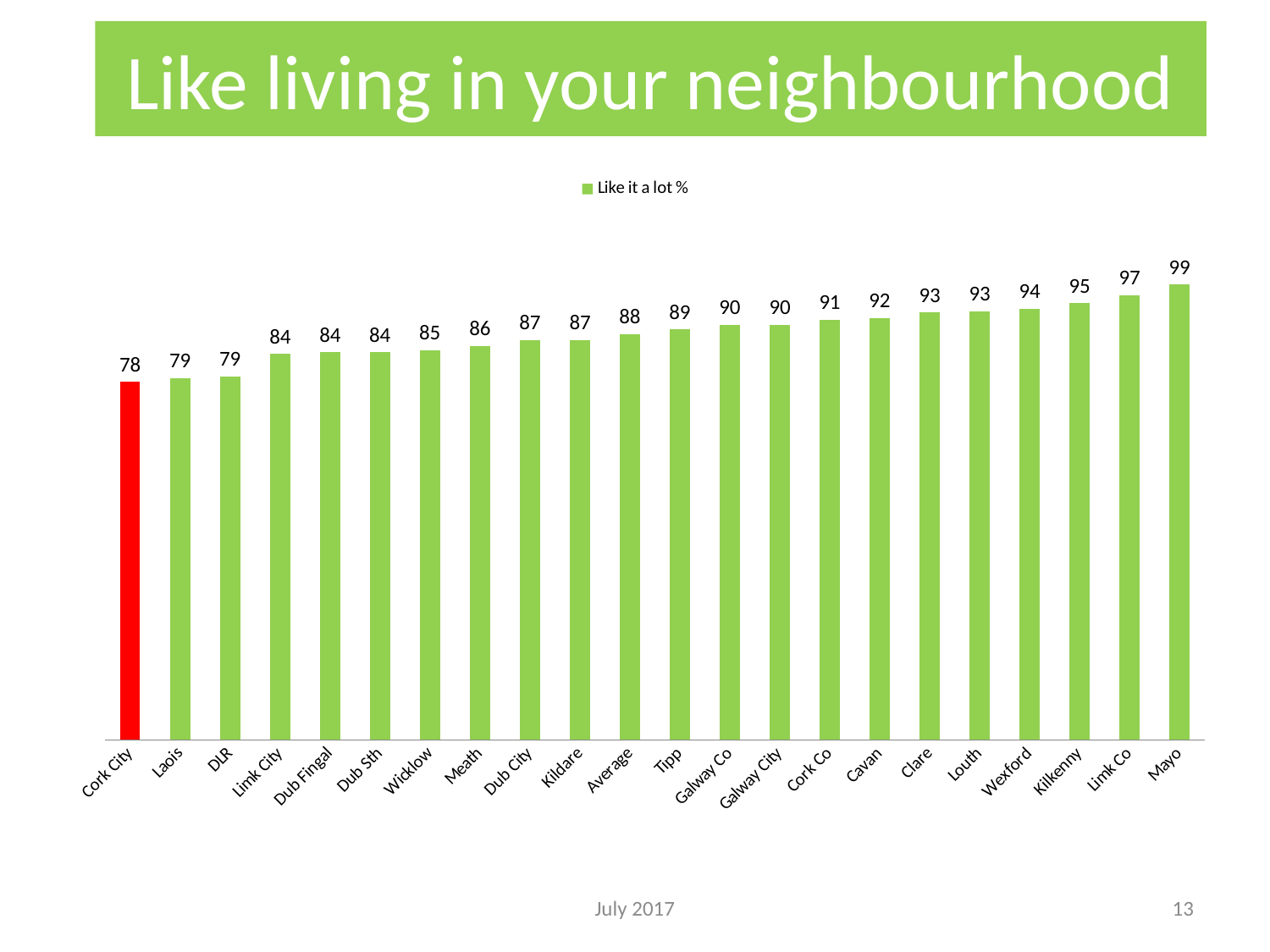
What kind of chart is shown on the slide? Bar chart What is the legend entry for the series shown? Like it a lot % What is the value for Wexford? 94 What is the value for Mayo? 99 Which category has the lowest value? Cork City How many series does the legend list? 1 What is the value for Average? 88 What is the difference between the values for Mayo and Cork City? 21 What is the value for Cork City? 78 How many categories are shown on the x axis? 22 Which category has the highest value? Mayo Which is larger, the value for Cavan or the value for Wicklow? Cavan